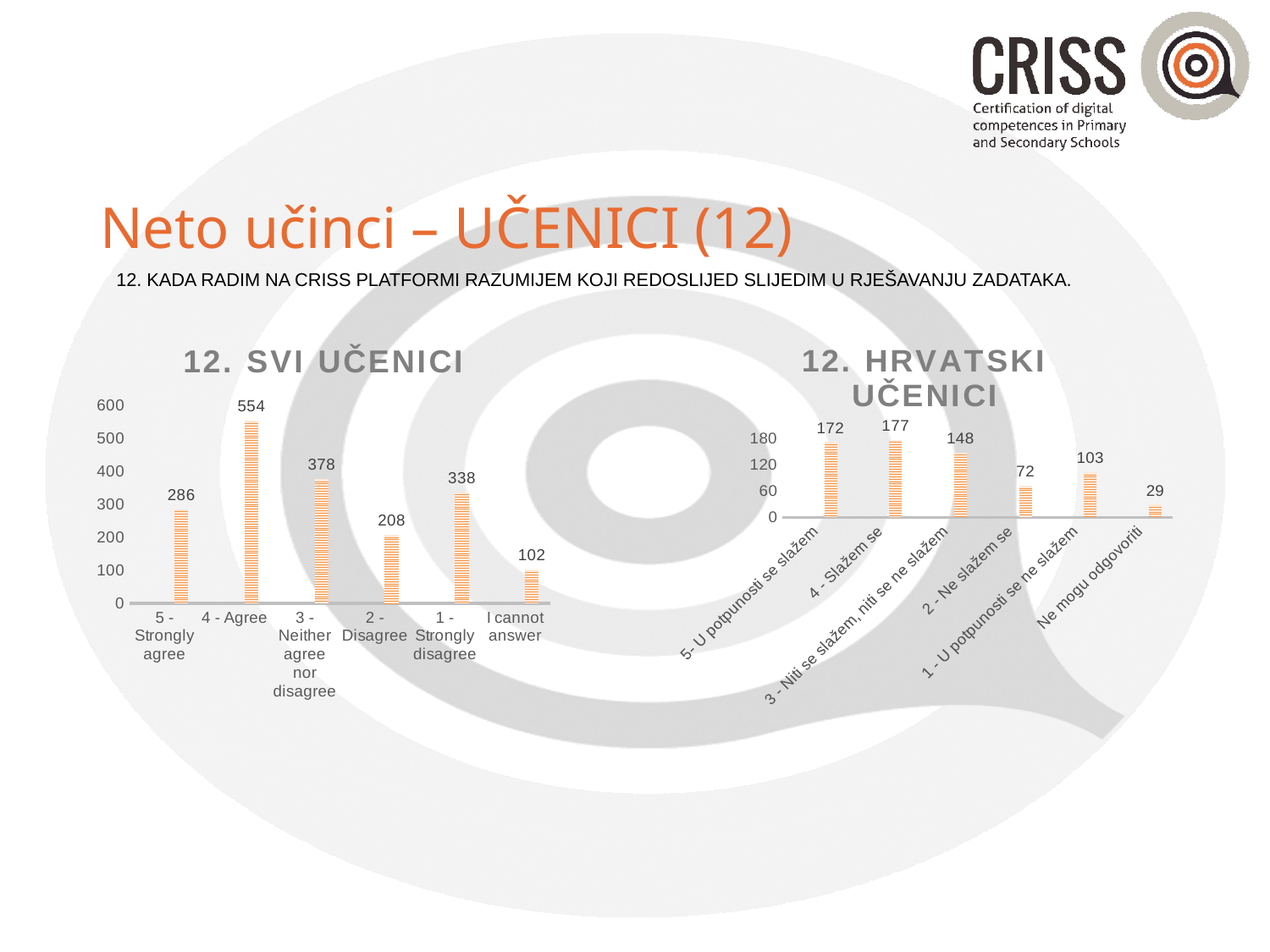
What type of chart is the chart titled "12. HRVATSKI UČENICI"? Bar chart In the chart titled "12. SVI UČENICI", what is the difference between the values for "4 - Agree" and "3 - Neither agree nor disagree"? 176 In the chart titled "12. HRVATSKI UČENICI", what is the value for "4 - Slažem se"? 177 In the chart titled "12. HRVATSKI UČENICI", which category has the lowest value? Ne mogu odgovoriti In the chart titled "12. SVI UČENICI", how many categories are shown? 6 In the chart titled "12. HRVATSKI UČENICI", what is the value for "Ne mogu odgovoriti"? 29 In the chart titled "12. HRVATSKI UČENICI", what is the difference between the values for "1 - U potpunosti se ne slažem" and "2 - Ne slažem se"? 31 In the chart titled "12. SVI UČENICI", which category has the lowest value? I cannot answer In the chart titled "12. SVI UČENICI", what is the value for "4 - Agree"? 554 In the chart titled "12. SVI UČENICI", what is the value for "I cannot answer"? 102 In the chart titled "12. SVI UČENICI", which category has the highest value? 4 - Agree In the chart titled "12. SVI UČENICI", which is larger: the value for "5 - Strongly agree" or the value for "1 - Strongly disagree"? 1 - Strongly disagree